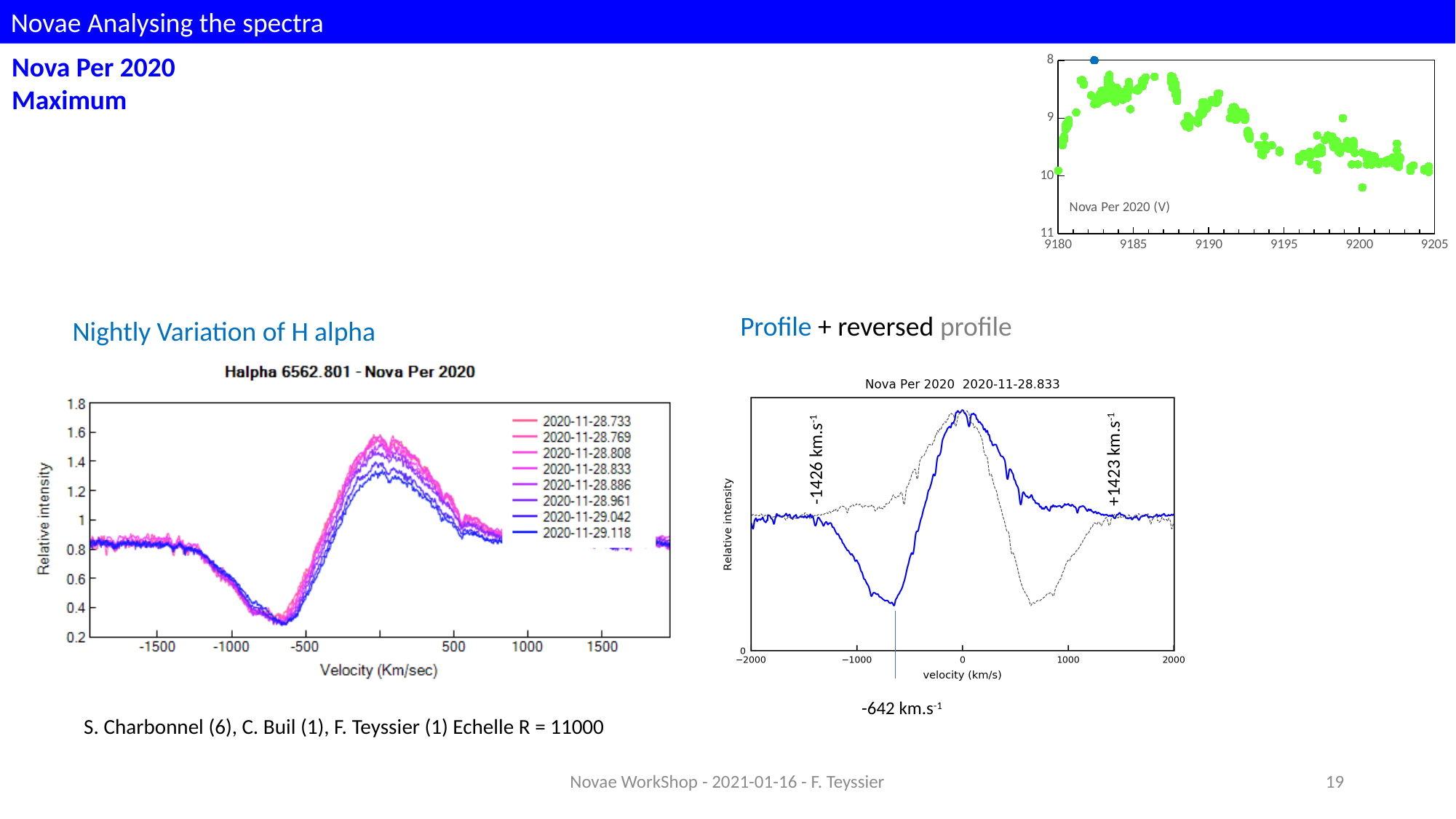
In the 'Halpha 6562.801 - Nova Per 2020' chart, what is the last entry in the legend? 2020-11-29.118 In the 'Halpha 6562.801 - Nova Per 2020' chart, how many series does the legend list? 8 In the 'Nova Per 2020 2020-11-28.833' profile chart, what velocity is annotated on the right side of the profile? +1423 km.s-1 In the 'Halpha 6562.801 - Nova Per 2020' chart, what is the first entry in the legend? 2020-11-28.733 What kind of chart is the 'Halpha 6562.801 - Nova Per 2020' chart? line chart In the 'Nova Per 2020 2020-11-28.833' profile chart, what velocity is annotated on the left side of the profile? -1426 km.s-1 In the 'Halpha 6562.801 - Nova Per 2020' chart, does the relative intensity rise or fall as velocity goes from -1000 to -600 Km/sec? fall In the 'Nova Per 2020 2020-11-28.833' profile chart, what velocity is annotated at the minimum of the absorption trough? -642 km.s-1 In the 'Halpha 6562.801 - Nova Per 2020' chart, is the relative intensity at a velocity of -1500 Km/sec greater or less than 1? less In the 'Halpha 6562.801 - Nova Per 2020' chart, is the relative intensity at a velocity of -600 Km/sec greater or less than 0.4? less What kind of chart is the 'Nova Per 2020 (V)' chart at the top right of the slide? scatter chart In the 'Halpha 6562.801 - Nova Per 2020' chart, is the peak relative intensity of the series greater or less than 1.2? greater